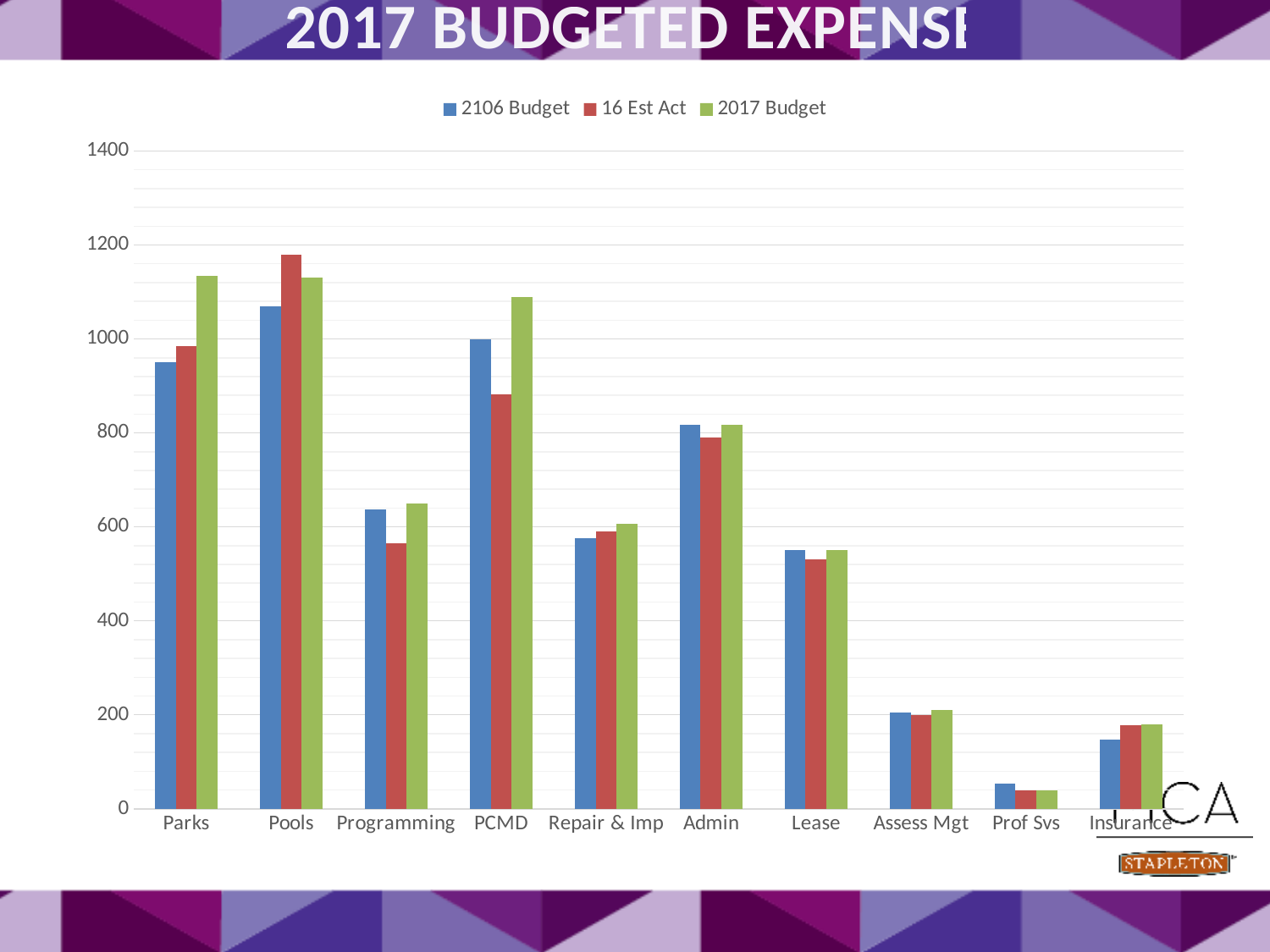
How many expense categories are shown on the x axis? 10 For PCMD, which is larger: the 2106 Budget value or the 2017 Budget value? 2017 Budget Which category has the lowest 2017 Budget value? Prof Svs For Pools, which is larger: the 16 Est Act value or the 2017 Budget value? 16 Est Act Is the 2106 Budget value for Insurance greater or less than 200? less What kind of chart is shown on the slide? bar chart Is the 2017 Budget value for Parks greater or less than 1000? greater Is the 16 Est Act value for PCMD greater or less than 1000? less Which category has the highest 2106 Budget value? Pools How many series does the legend list? 3 Which category has the highest 16 Est Act value? Pools What colour represents the 2017 Budget series in the legend? green